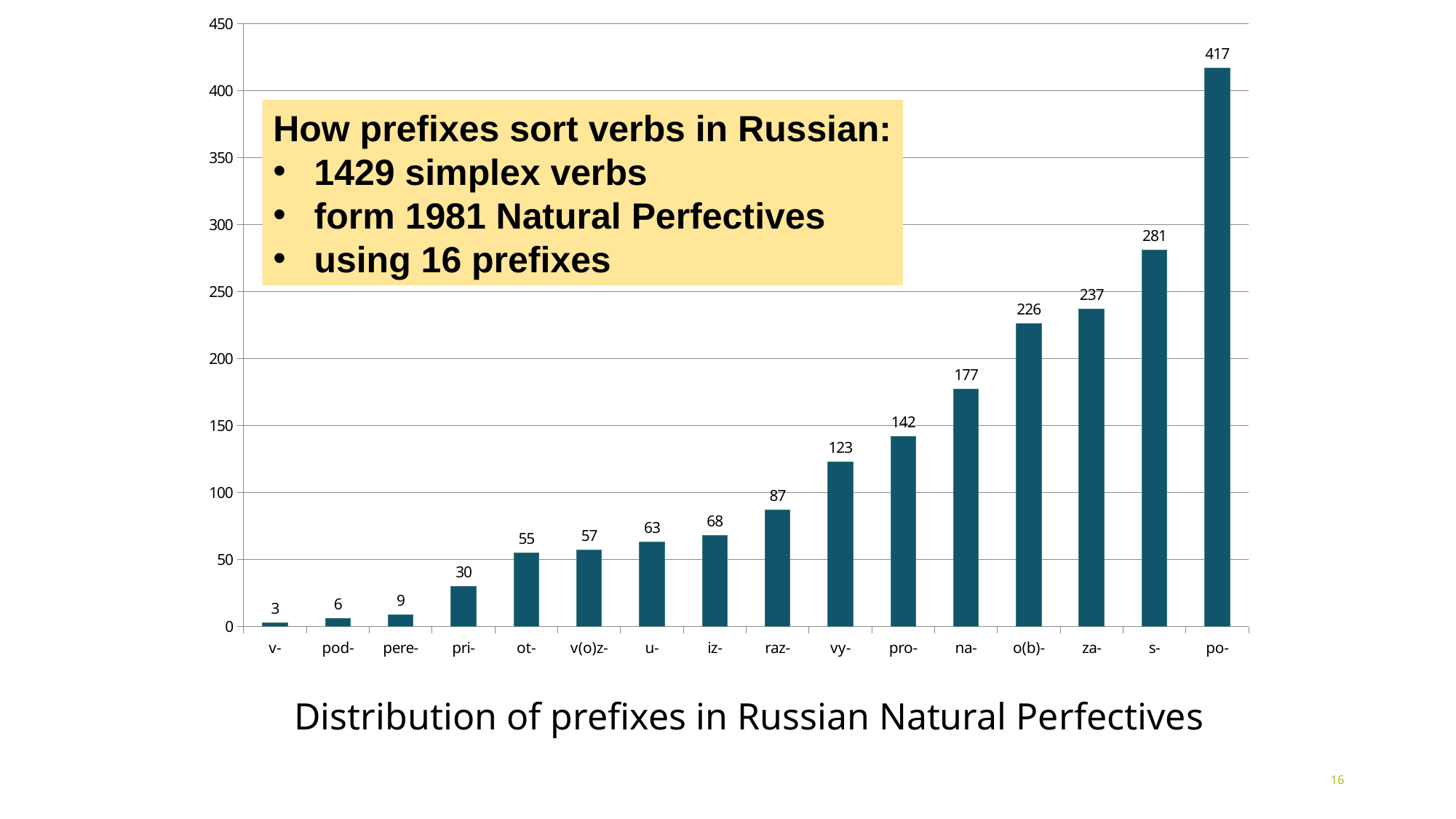
How many prefixes are shown on the x axis? 16 What is the value for the prefix raz-? 87 What is the difference between the values for s- and za-? 44 Is the value for vy- greater or less than 100? greater Do the values rise or fall from left to right along the x axis? rise What is the value for the prefix o(b)-? 226 What is the value for the prefix po-? 417 What kind of chart is shown on the slide? bar chart Which has a larger value, na- or pro-? na- Which prefix has the lowest value? v- What is the difference between the values for po- and s-? 136 Which prefix has the highest value? po-